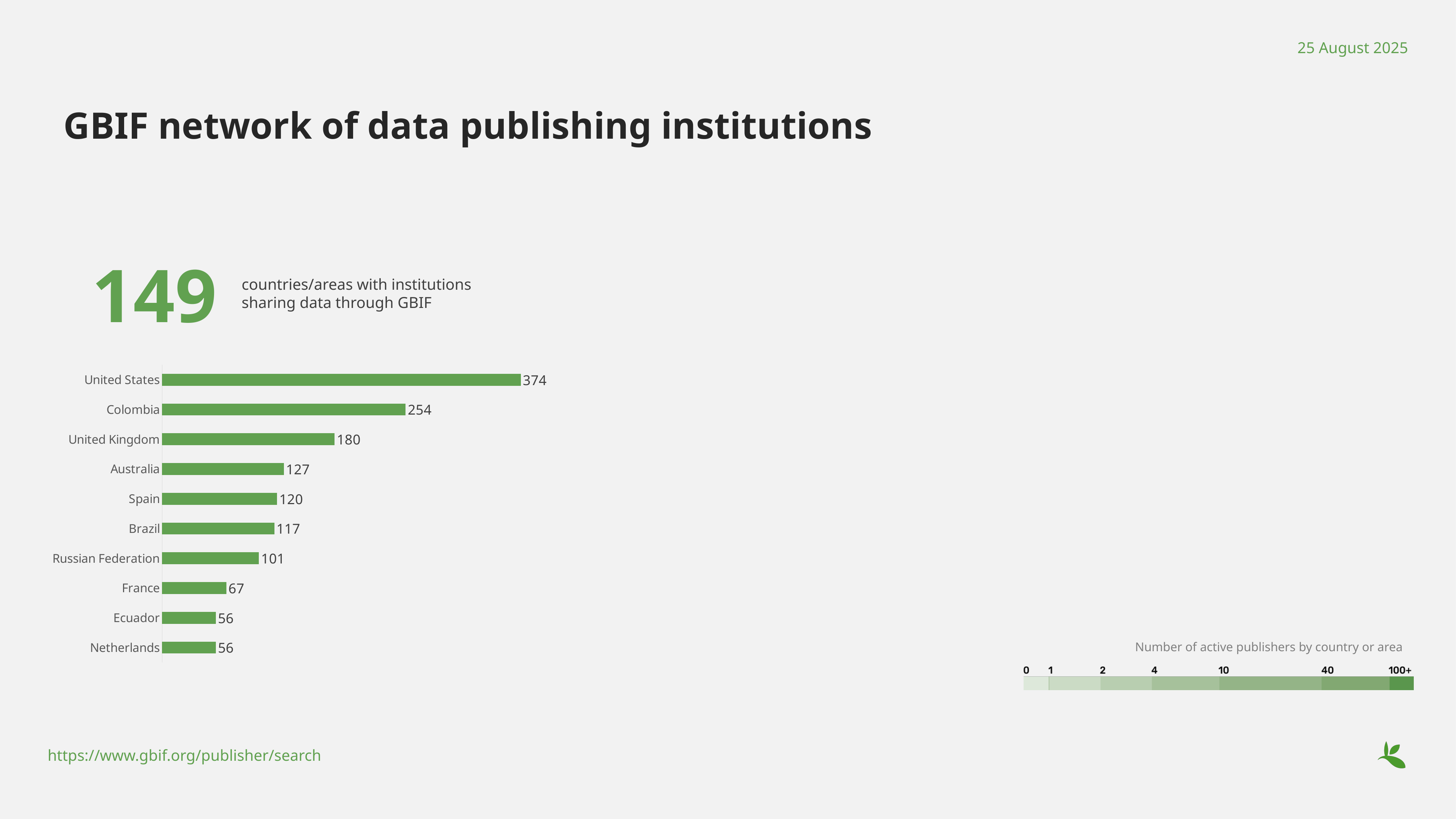
Which has a larger value, Colombia or the United Kingdom? Colombia Which has a larger value, Spain or Brazil? Spain What is the value for Ecuador? 56 What is the value for the United States? 374 What is the difference between the values for the United States and Colombia? 120 What is the value for the Russian Federation? 101 How many countries are shown in the bar chart? 10 What is the value for Colombia? 254 What is the value for France? 67 What kind of chart is shown on the slide? Bar chart What is the difference between the values for the United Kingdom and Australia? 53 Which country has the highest value? United States